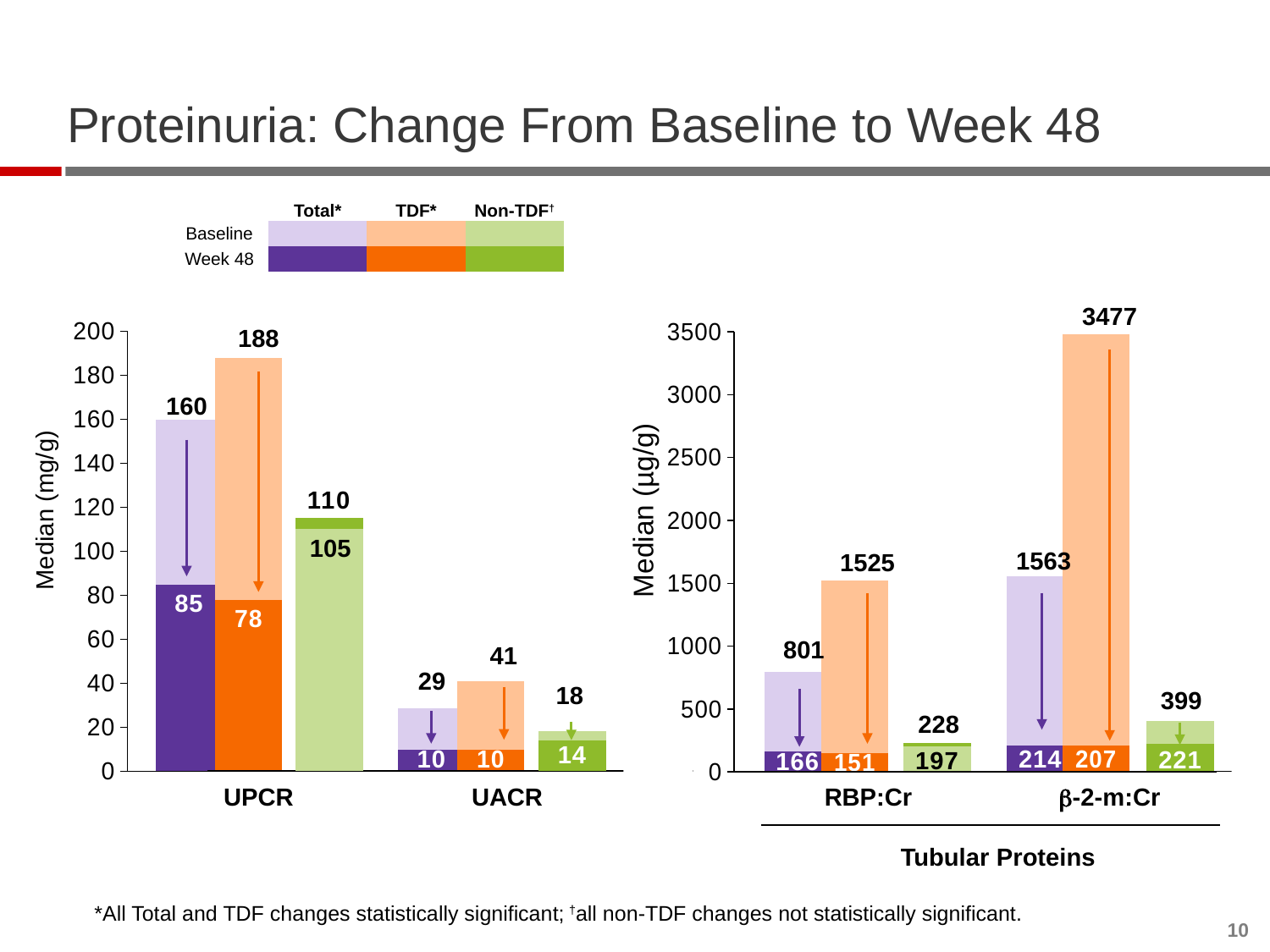
How many groups does the legend list? 3 In the left chart (Median mg/g), what is the baseline UPCR value for the TDF group? 188 In the left chart (Median mg/g), what is the difference between the baseline and Week 48 UPCR values for the Total group? 75 In the right chart (Tubular Proteins), which group has the lowest baseline RBP:Cr value? Non-TDF In the right chart (Tubular Proteins), what is the difference between the baseline and Week 48 β-2-m:Cr values for the TDF group? 3270 What type of chart is used on this slide? bar chart In the left chart (Median mg/g), what is the Week 48 UPCR value for the Total group? 85 In the right chart (Tubular Proteins), what is the Week 48 RBP:Cr value for the Non-TDF group? 197 In the right chart (Tubular Proteins), is the baseline RBP:Cr value for the TDF group greater or less than 1500? greater In the left chart (Median mg/g), which group has the highest baseline UPCR value? TDF In the left chart (Median mg/g), is the baseline UACR value for the TDF group larger or smaller than the baseline UACR value for the Total group? larger In the right chart (Tubular Proteins), what is the baseline β-2-m:Cr value for the TDF group? 3477